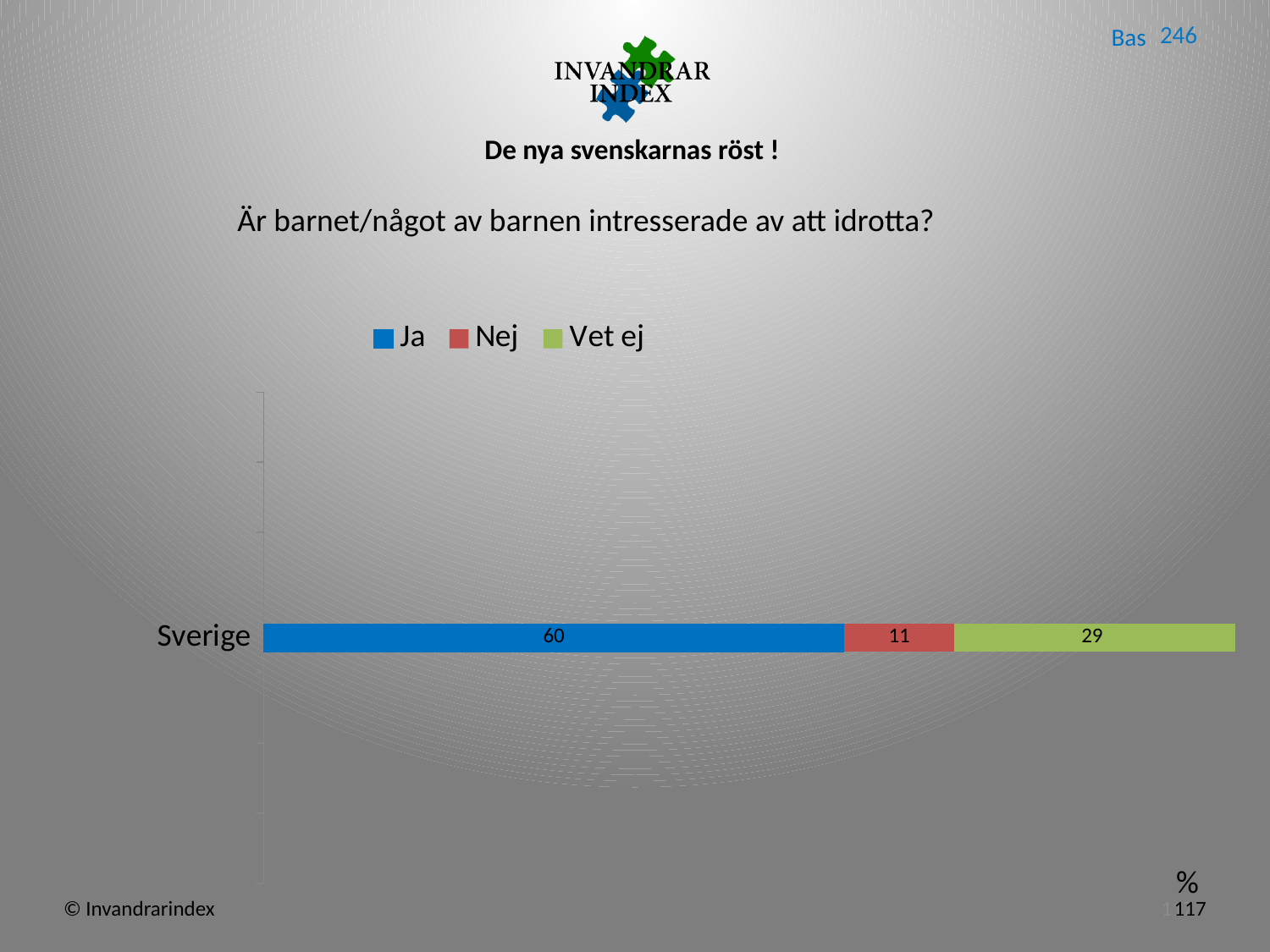
What is the difference between the Ja and Vet ej values for Sverige? 31 What is the total of the stacked bar for Sverige? 100 What is the difference between the Vet ej and Nej values for Sverige? 18 Which is larger for Sverige, Nej or Vet ej? Vet ej Which series has the highest value for Sverige? Ja What value is shown for Nej for Sverige? 11 What kind of chart is shown on the slide? Stacked bar chart What value is shown for Vet ej for Sverige? 29 How many categories are plotted on the chart? 1 What value is shown for Ja for Sverige? 60 How many series does the legend list? 3 Which series has the lowest value for Sverige? Nej